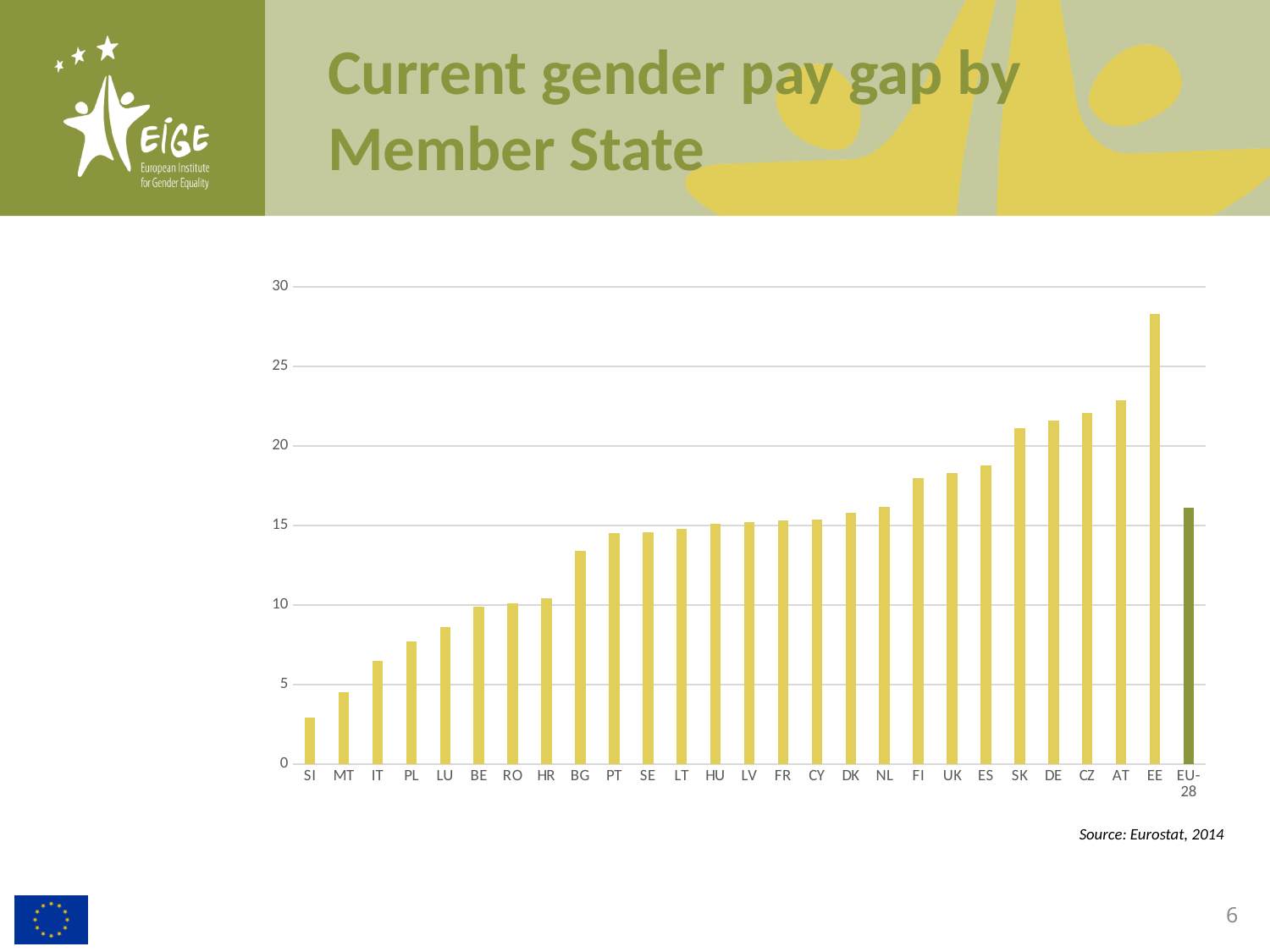
What is the title of the slide containing the chart? Current gender pay gap by Member State Is the value for BG greater or less than 15? less How many Member State / aggregate categories are plotted along the x axis? 27 Do the bar values rise or fall from SI to EE along the x axis? rise Is the value for EU-28 greater or less than 15? greater What kind of chart is shown on the slide? bar chart Which has the larger gender pay gap, DE or IT? DE Is the value for AT greater or less than 20? greater Which category has the highest gender pay gap? EE Which category has the lowest gender pay gap? SI